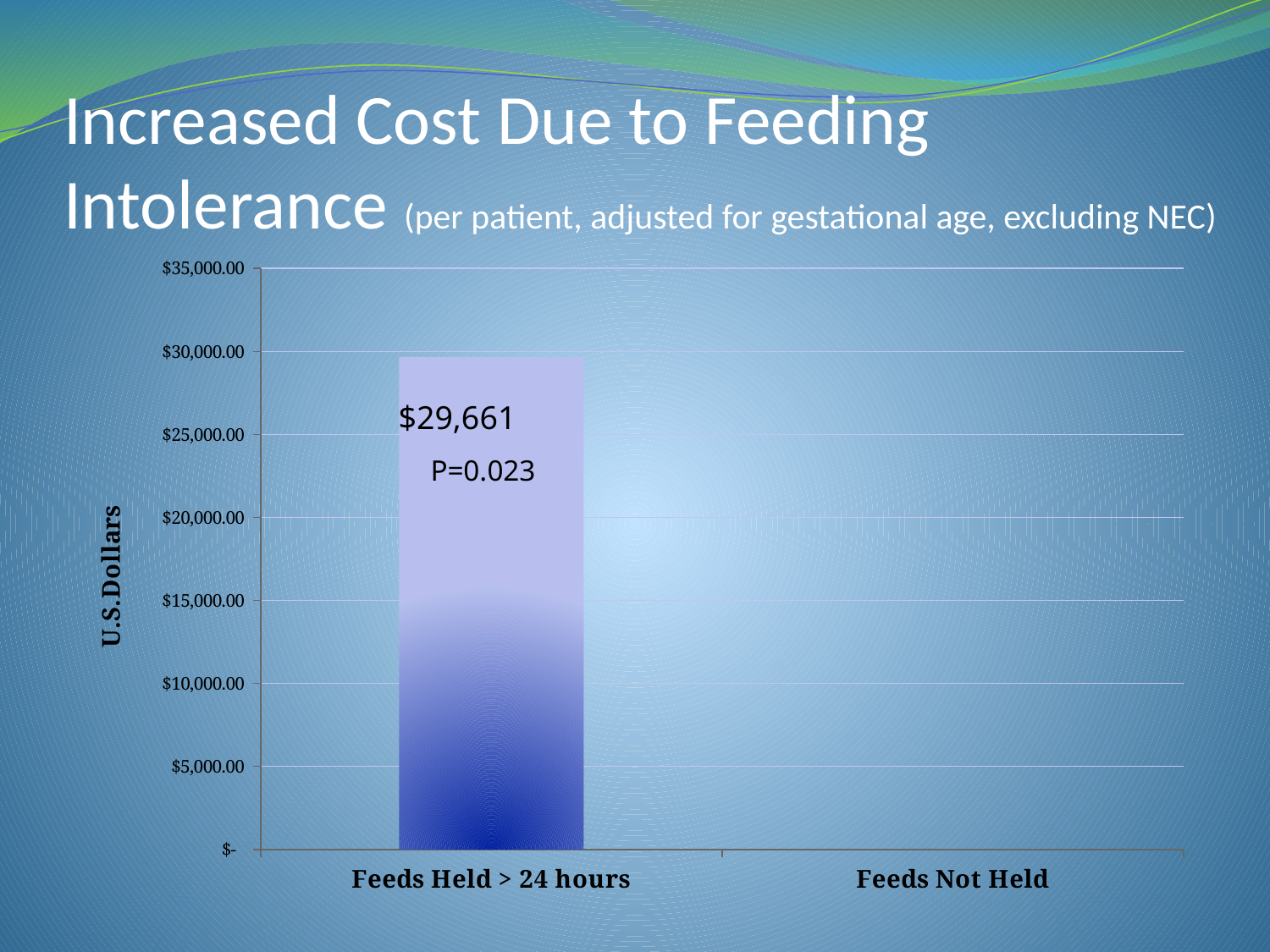
What is the value shown for Feeds Held > 24 hours? $29,661 What is the highest value shown on the y axis? $35,000.00 Is the value for Feeds Held > 24 hours greater or less than $30,000.00? less Which category has the highest value? Feeds Held > 24 hours Which category has the higher value, Feeds Held > 24 hours or Feeds Not Held? Feeds Held > 24 hours What kind of chart is shown on the slide? bar chart What P value is printed on the bar for Feeds Held > 24 hours? P=0.023 Is the value for Feeds Held > 24 hours greater or less than $25,000.00? greater What is the label on the y axis? U.S.Dollars How many categories are shown on the x axis? 2